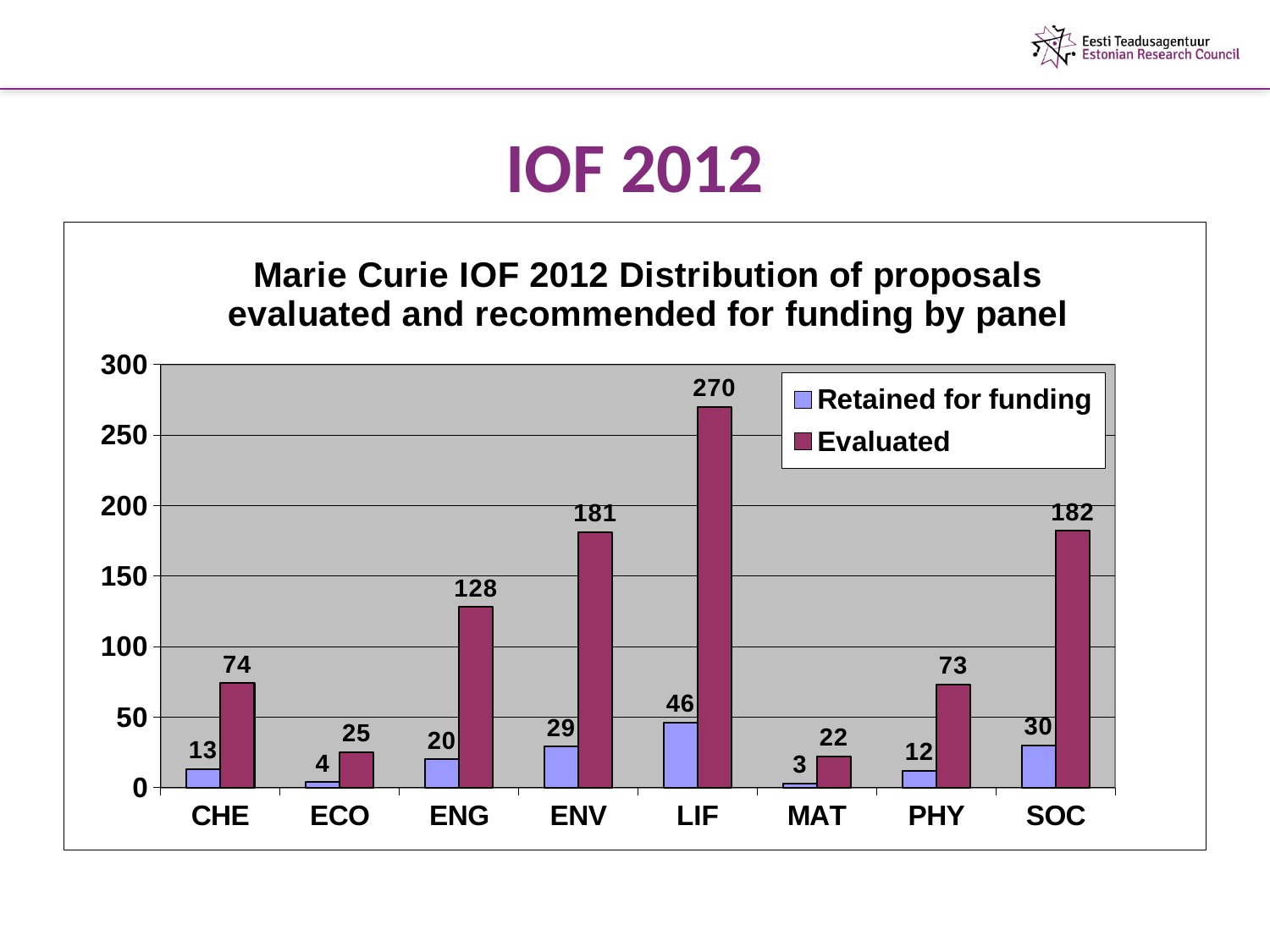
Which panel has the lowest number of proposals Retained for funding? MAT Is the Evaluated value for ENV greater or less than 150? greater What kind of chart is shown on the slide? Bar chart What is the title of the chart? Marie Curie IOF 2012 Distribution of proposals evaluated and recommended for funding by panel How many proposals were Retained for funding in the ECO panel? 4 How many panels are shown on the x axis? 8 Which panel has more Evaluated proposals, ENG or PHY? ENG What is the difference between the Evaluated and Retained for funding values for the SOC panel? 152 How many proposals were Evaluated in the LIF panel? 270 How many proposals were Retained for funding in the ENV panel? 29 How many series does the legend list? 2 Which panel has the highest number of Evaluated proposals? LIF